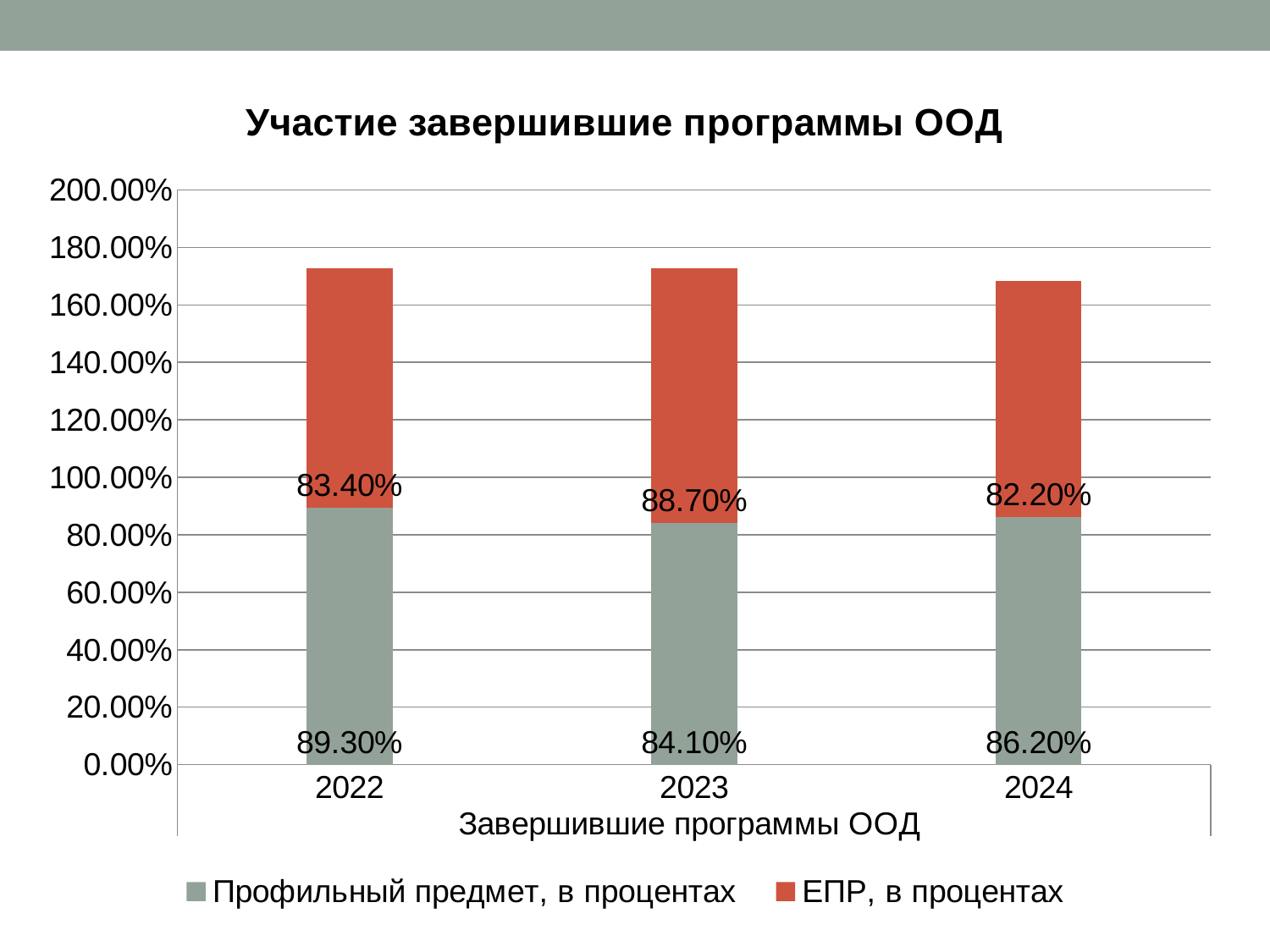
What is the value for Профильный предмет, в процентах in 2022? 89.30% Which is larger in 2023: Профильный предмет, в процентах or ЕПР, в процентах? ЕПР, в процентах Which year has the highest value for Профильный предмет, в процентах? 2022 What is the value for ЕПР, в процентах in 2023? 88.70% What is the value for ЕПР, в процентах in 2024? 82.20% What kind of chart is shown on the slide? Stacked bar chart What is the total of the stacked bar for 2024? 168.40% Which year has the lowest value for ЕПР, в процентах? 2024 How many series does the legend list? 2 How many years are shown on the x axis? 3 What is the title of the chart? Участие завершившие программы ООД What is the difference between the Профильный предмет values for 2022 and 2023? 5.20%